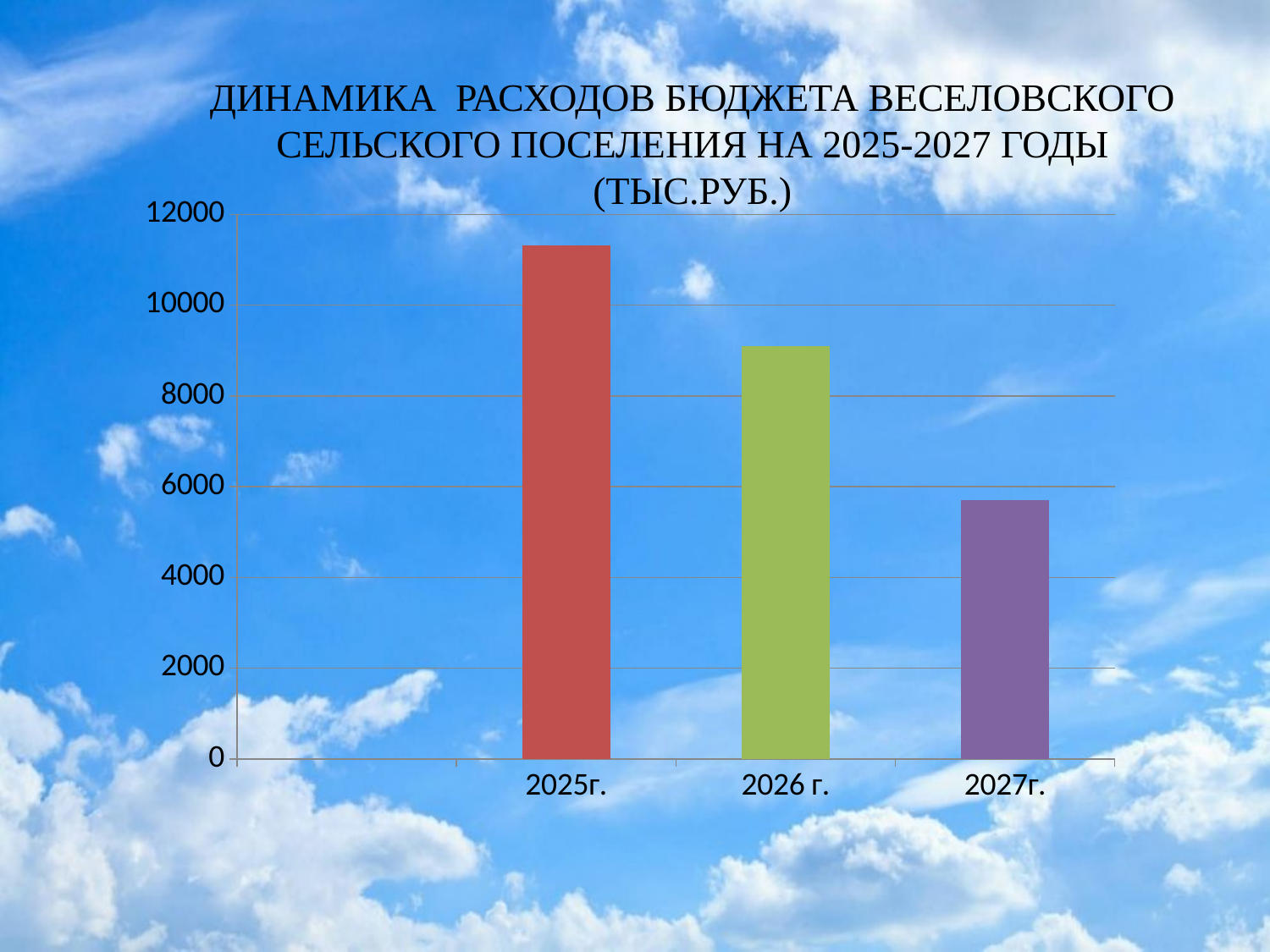
Which year has the highest budget expenditure? 2025г. Is the value for 2026 г. greater or less than 8000? greater Is the value for 2027г. greater or less than 6000? less Is the value for 2026 г. greater or less than 10000? less Which year has the lowest budget expenditure? 2027г. Do the values rise or fall from 2025г. to 2027г.? fall Which is larger, the value for 2025г. or the value for 2026 г.? 2025г. In what units are the values on the chart expressed, according to the title? ТЫС.РУБ. How many bars (categories) does the chart show? 3 Which is larger, the value for 2026 г. or the value for 2027г.? 2026 г. What kind of chart is shown on the slide? bar chart